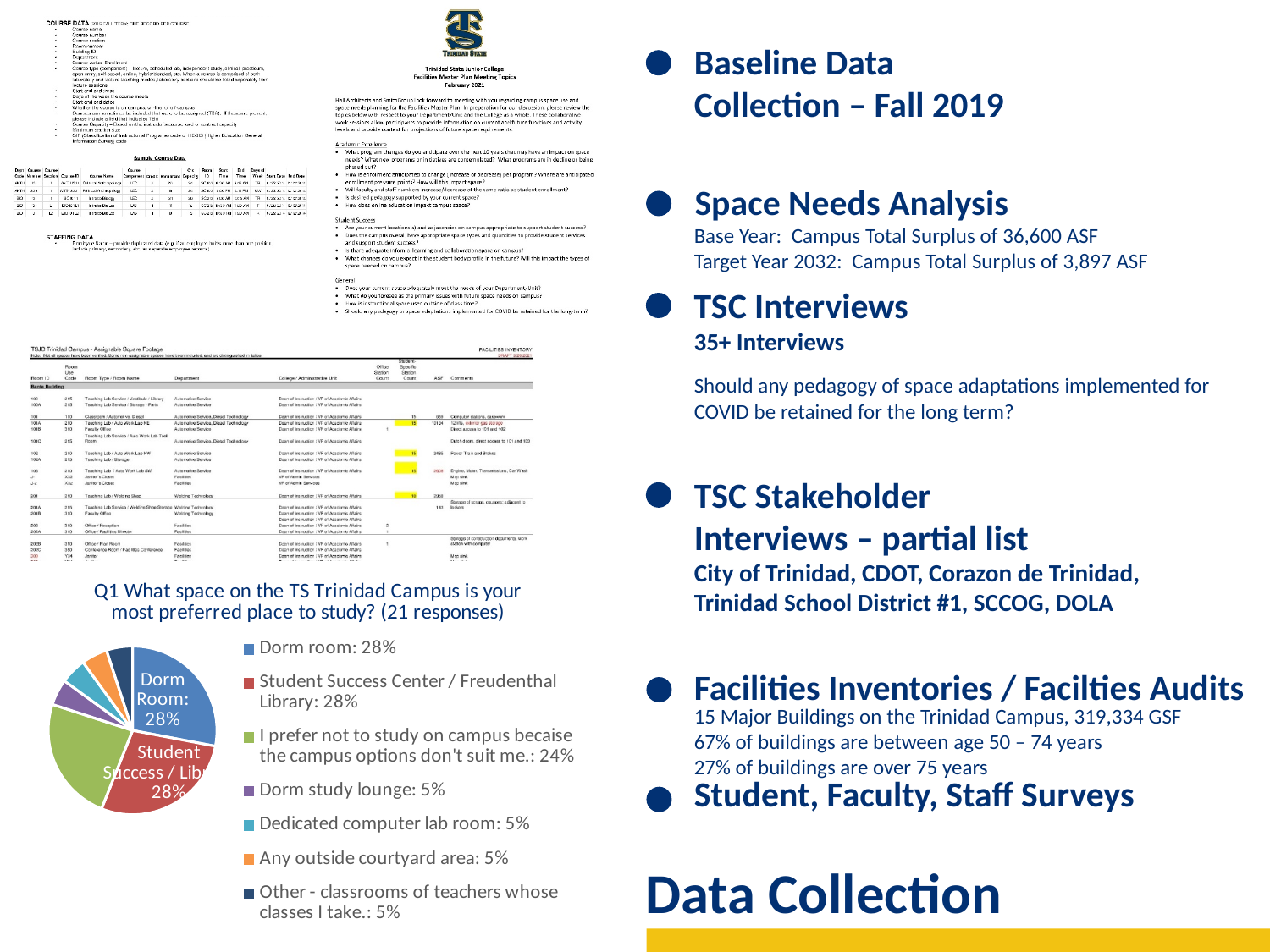
What percentage of responses chose Dorm study lounge? 5% What percentage of responses chose Student Success Center / Freudenthal Library? 28% Which is larger: the share for Dorm room or the share for 'I prefer not to study on campus'? Dorm room What share of responses said they prefer not to study on campus because the campus options don't suit them? 24% What percentage of responses chose Dedicated computer lab room? 5% How many responses does the chart title say the survey question received? 21 responses What is the difference in percentage points between the Dorm room share and the Dorm study lounge share? 23 What percentage of responses chose Dorm room as their most preferred place to study? 28% What is the difference in percentage points between the Dorm room share and the 'I prefer not to study on campus' share? 4 How many categories does the pie chart show? 7 What kind of chart is shown on the slide? pie chart What percentage of responses chose Any outside courtyard area? 5%